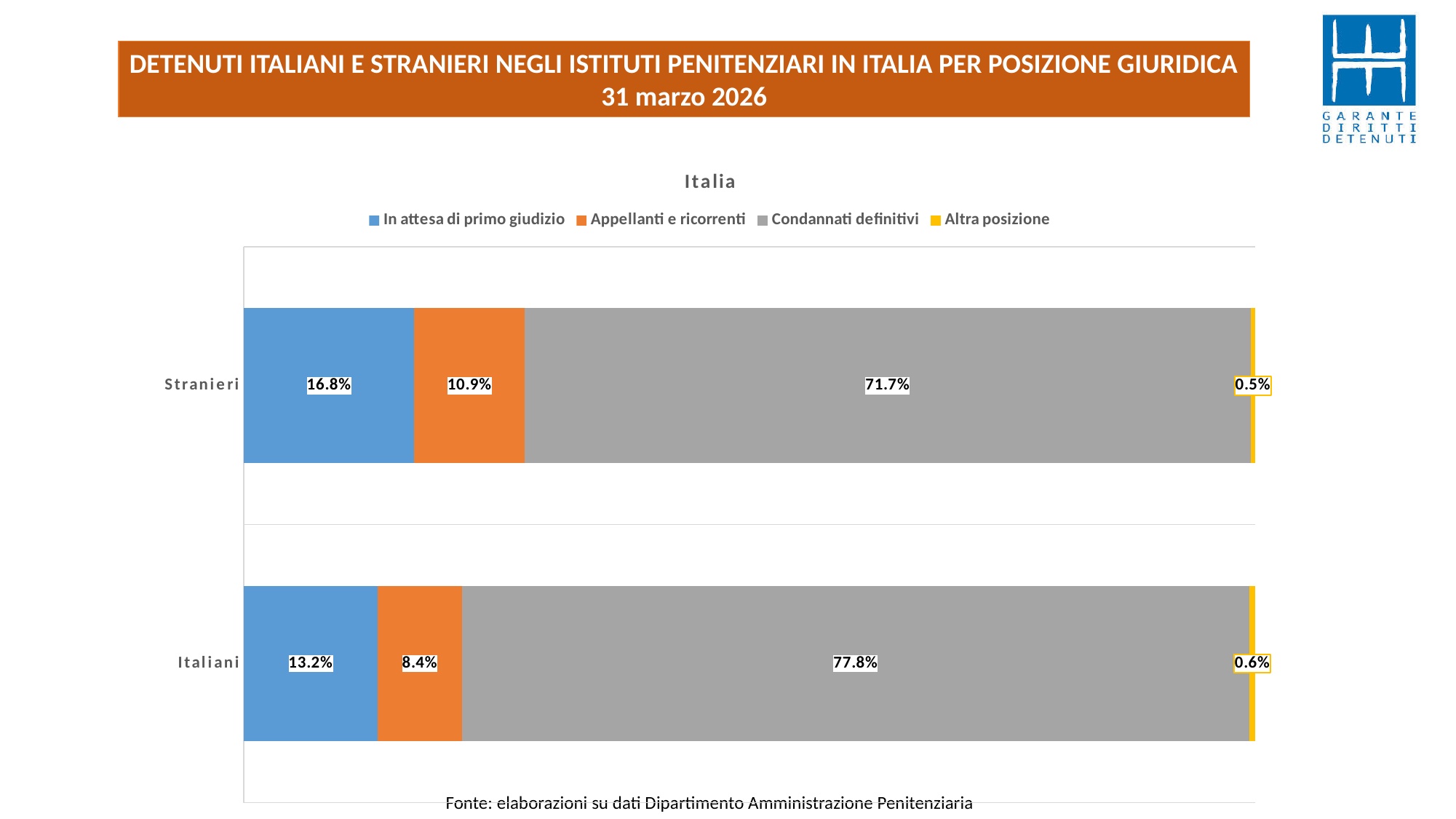
Which series has the smallest value for Italiani? Altra posizione Which series has the largest value for Stranieri? Condannati definitivi What is the difference between the 'In attesa di primo giudizio' values for Stranieri and Italiani? 3.6% Which category has the higher value for 'Condannati definitivi', Stranieri or Italiani? Italiani What is the value for 'Appellanti e ricorrenti' for Stranieri? 10.9% How many categories are shown on the chart? 2 What is the value for 'Altra posizione' for Italiani? 0.6% How many series does the legend list? 4 What is the value for 'Condannati definitivi' for Italiani? 77.8% What kind of chart is shown on the slide? Stacked bar chart What is the value for 'In attesa di primo giudizio' for Stranieri? 16.8% What is the difference between the 'Condannati definitivi' values for Italiani and Stranieri? 6.1%